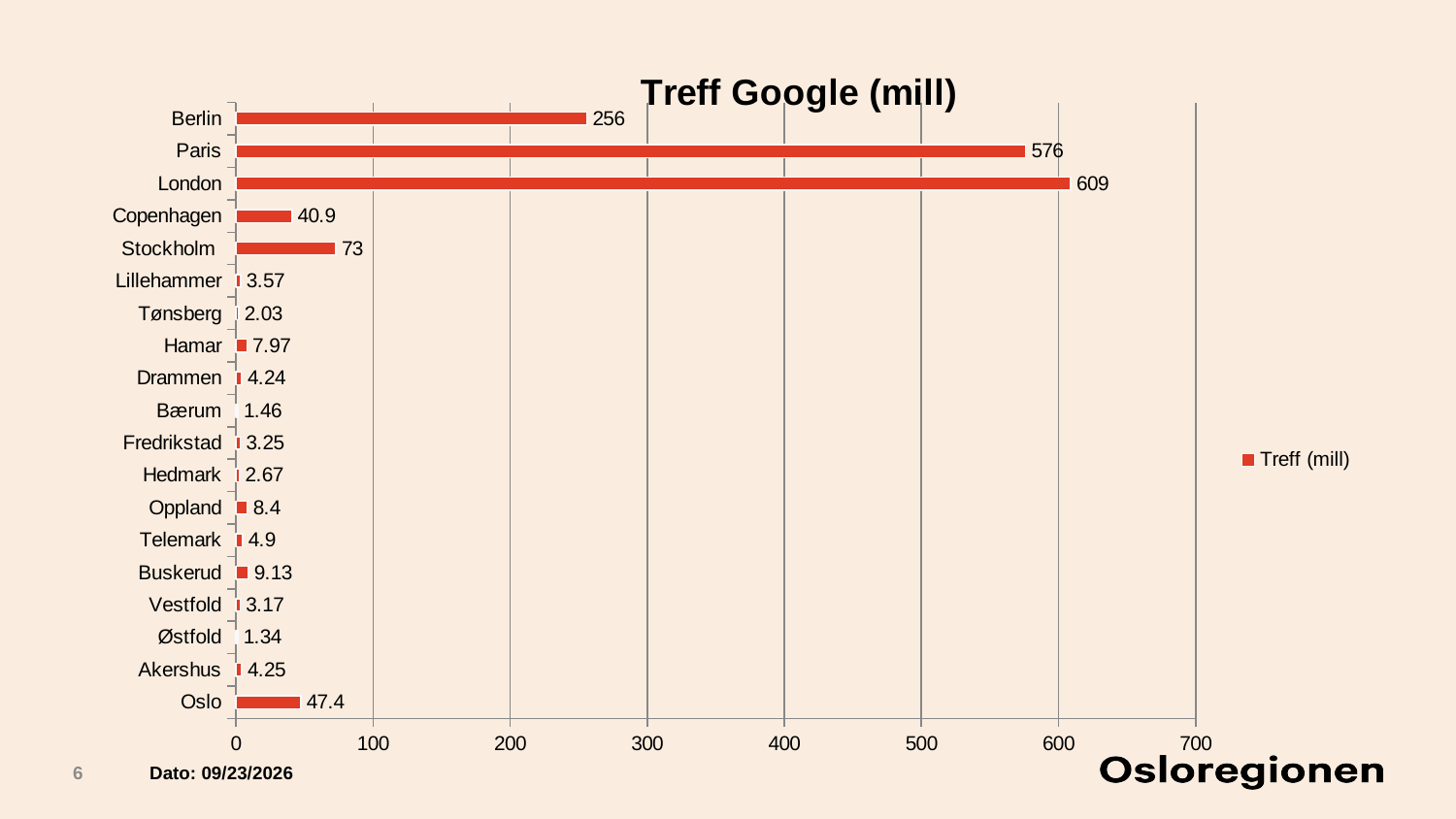
What is the value for Copenhagen? 40.9 What is the difference between the values for Stockholm and Copenhagen? 32.1 What is the value for Buskerud? 9.13 What is the value for London? 609 Which is larger, the value for Berlin or the value for Paris? Paris What kind of chart is this? bar chart What is the title of the chart? Treff Google (mill) Which category has the highest value? London Which category has the lowest value? Østfold How many categories are shown on the chart? 19 What is the difference between the values for London and Paris? 33 What is the value for Oslo? 47.4